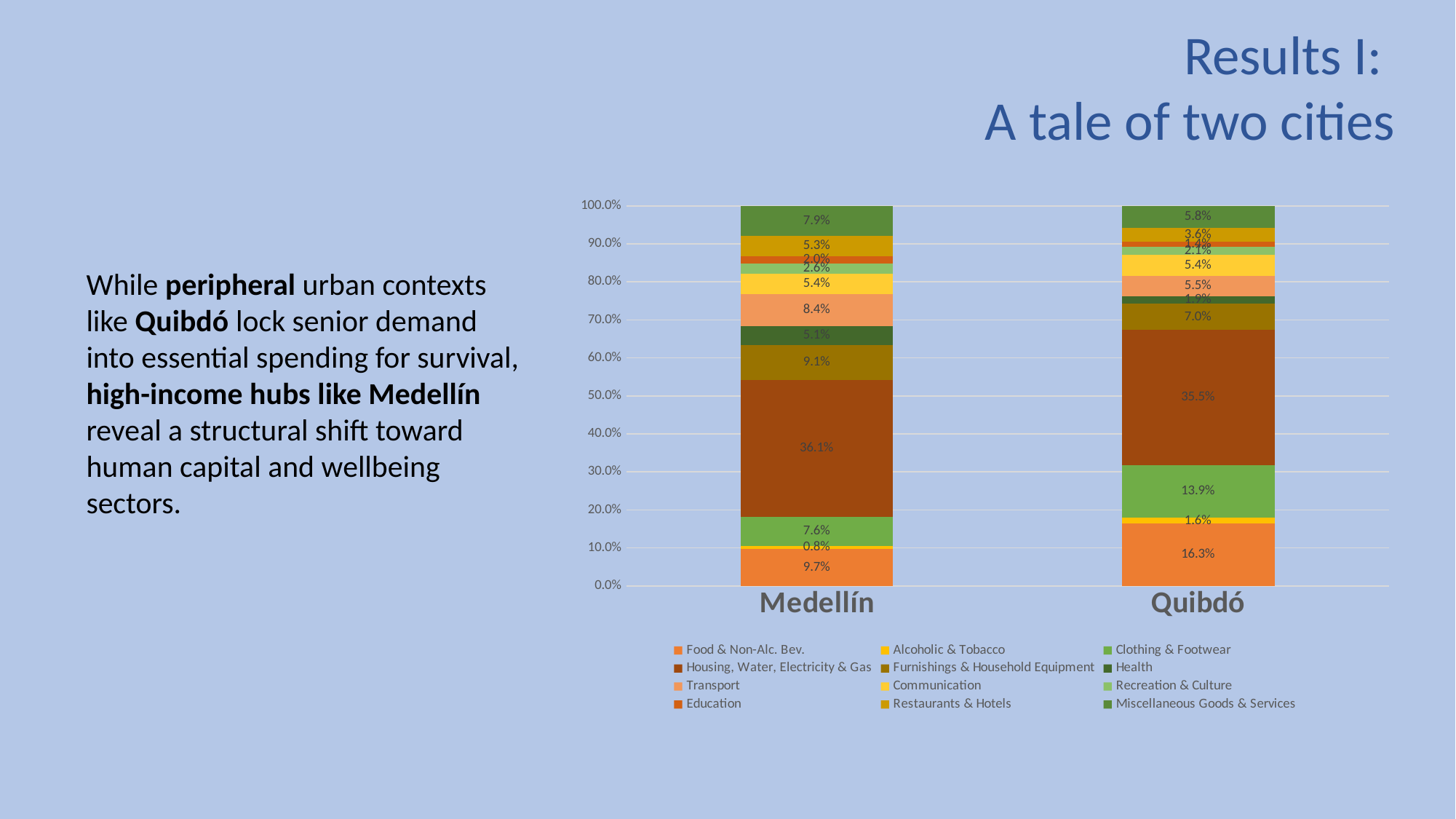
What is the share of Transport for Medellín? 8.4% Which spending category is the largest segment in the Medellín bar? Housing, Water, Electricity & Gas How many series does the chart's legend list? 12 What is the share of Food & Non-Alc. Bev. for Quibdó? 16.3% Which spending category is the smallest segment in the Medellín bar? Alcoholic & Tobacco Which city has the larger share for Clothing & Footwear? Quibdó What is the share of Clothing & Footwear for Quibdó? 13.9% Which city has the larger share for Miscellaneous Goods & Services? Medellín How many cities (categories) are shown on the x axis of the chart? 2 What is the share of Housing, Water, Electricity & Gas for Medellín? 36.1% What is the difference between the Food & Non-Alc. Bev. shares of Quibdó and Medellín? 6.6% What kind of chart is shown on the slide? Stacked bar chart